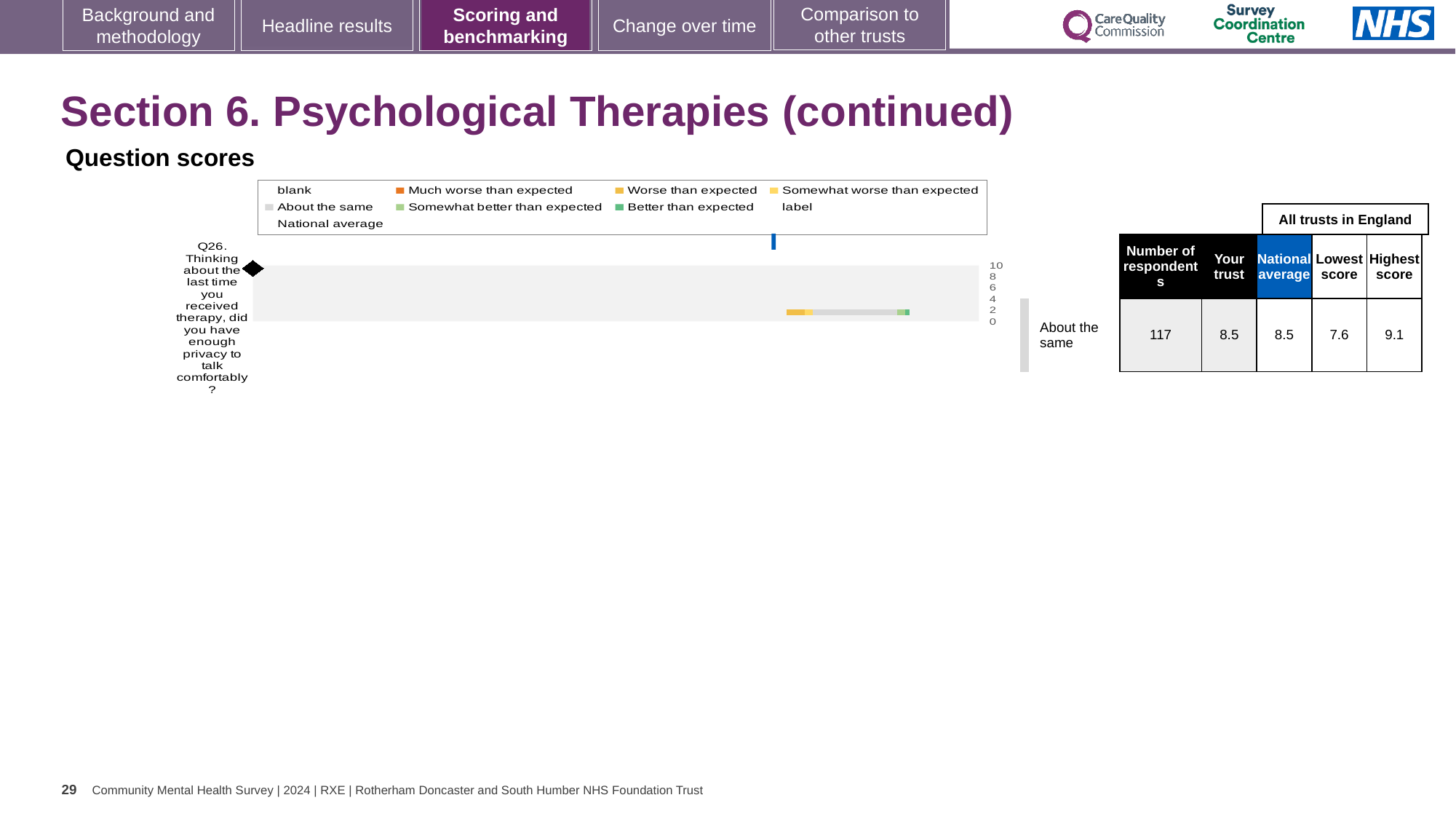
In the table beside the chart, what is the 'Your trust' score for Q26? 8.5 Which question number is plotted in the Question scores chart? Q26 In the table beside the chart, what is the lowest score among all trusts in England for Q26? 7.6 In the table beside the chart, what is the highest score among all trusts in England for Q26? 9.1 In the table beside the chart, how many respondents answered Q26? 117 How many survey questions are plotted in the Question scores chart? 1 In the chart legend, what colour represents 'Much worse than expected'? orange What is the highest value shown on the chart's numeric axis? 10 What kind of chart is shown under 'Question scores'? bar chart In the table beside the chart, what is the national average score for Q26? 8.5 In the table beside the chart, what is the difference between the highest score and the lowest score for Q26? 1.5 What benchmark category label is shown next to the chart for Q26? About the same